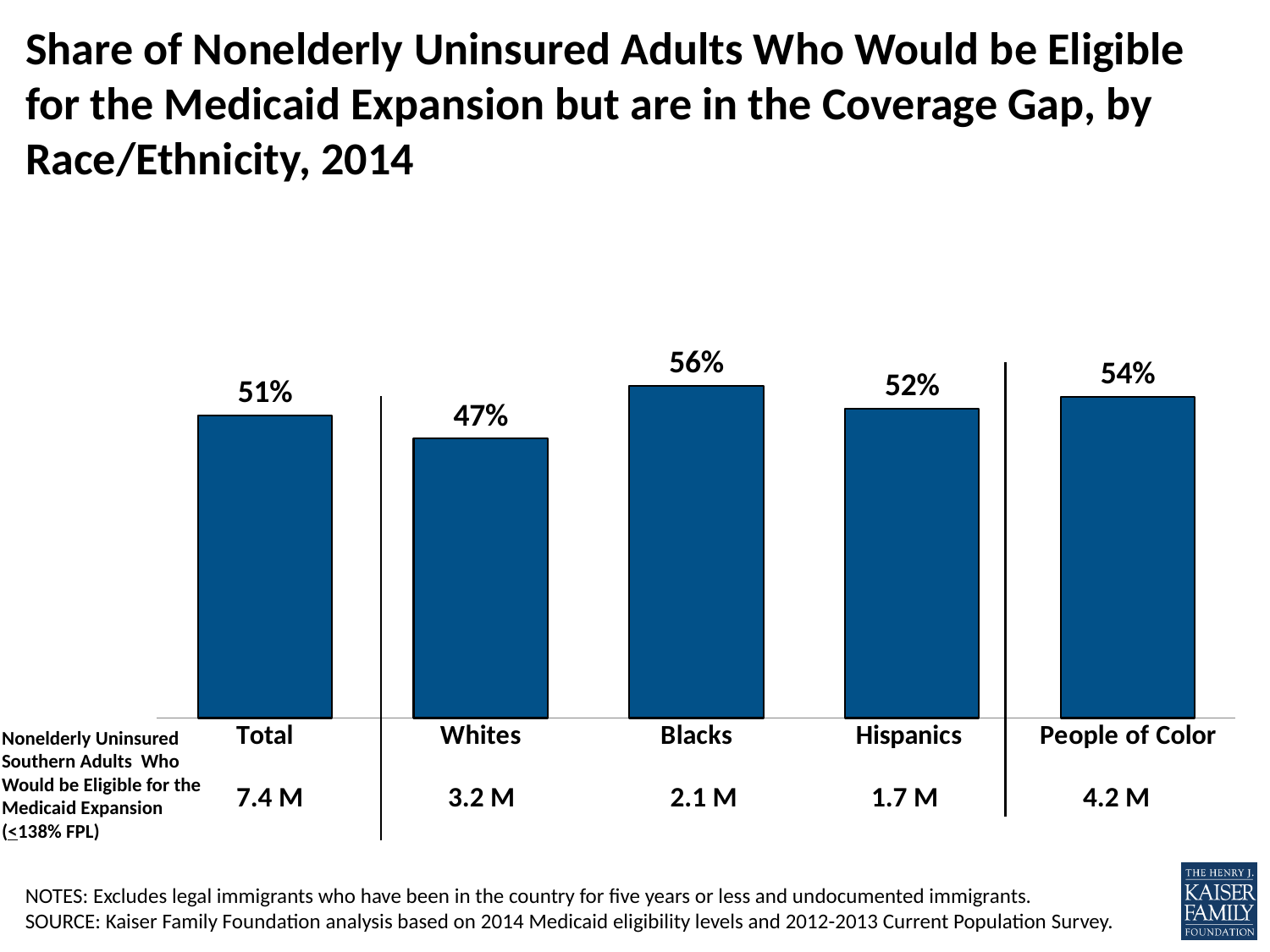
How many nonelderly uninsured Southern adults who would be eligible for the Medicaid expansion are listed under Hispanics? 1.7 M What is the value for Blacks? 56% Which category has the highest value? Blacks Which category has the lowest value? Whites How many categories are shown in the chart? 5 What is the value for Total? 51% What is the value for Whites? 47% What is the difference between the values for Blacks and Whites? 9% What kind of chart is shown on the slide? Bar chart Which is larger, the value for Hispanics or the value for Whites? Hispanics What is the value for People of Color? 54% What year does the chart title refer to? 2014